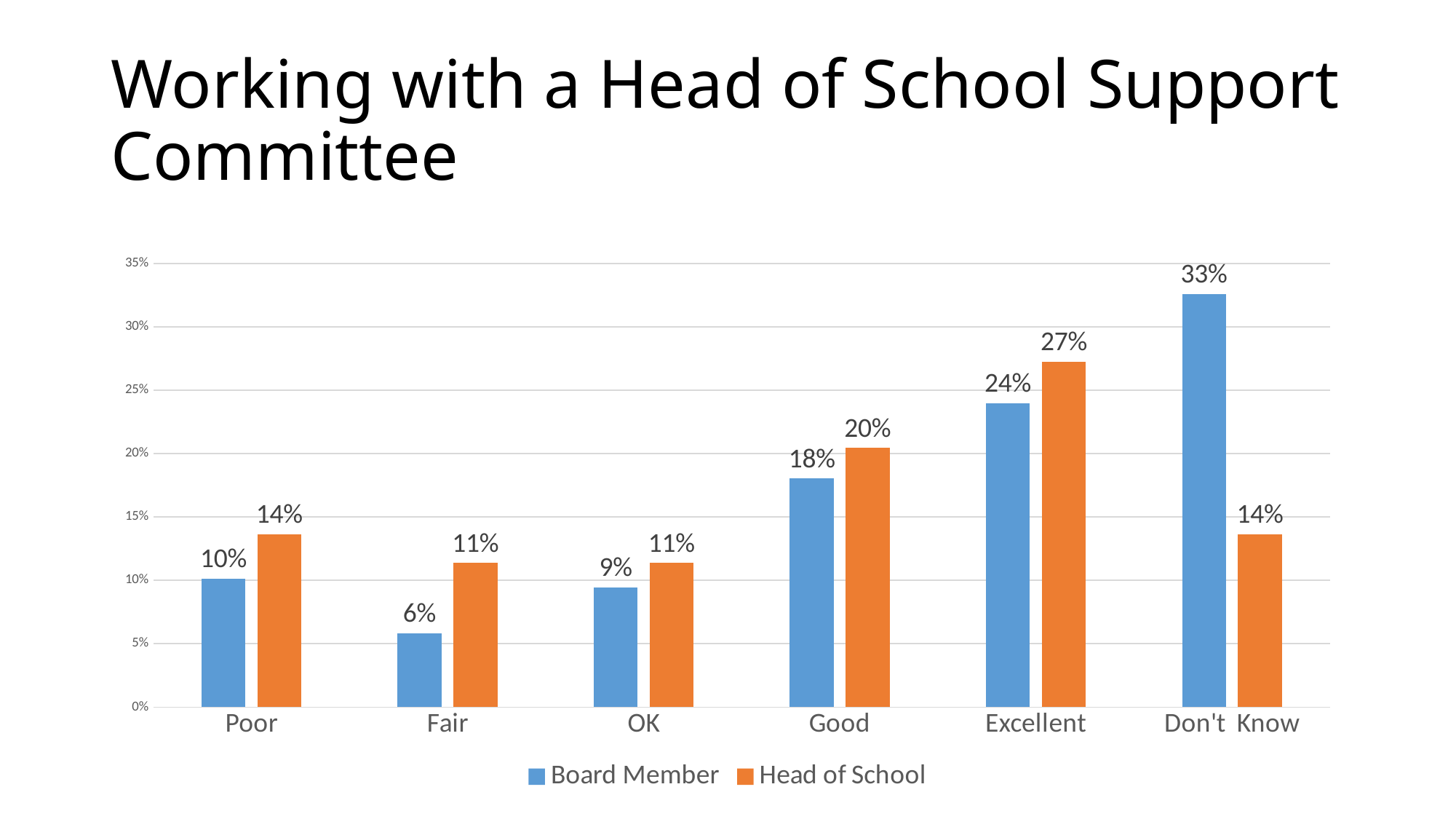
How many categories are shown on the x axis? 6 What is the Head of School value for Don't Know? 14% What is the Board Member value for Good? 18% Which category has the lowest Board Member value? Fair Which is larger for Fair: the Board Member value or the Head of School value? Head of School What is the difference between the Board Member and Head of School values for Don't Know? 19% Which category has the highest Head of School value? Excellent What is the Head of School value for Excellent? 27% Which category has the highest Board Member value? Don't Know What kind of chart is shown on the slide? Bar chart What colour are the Head of School bars? Orange How many series does the legend list? 2